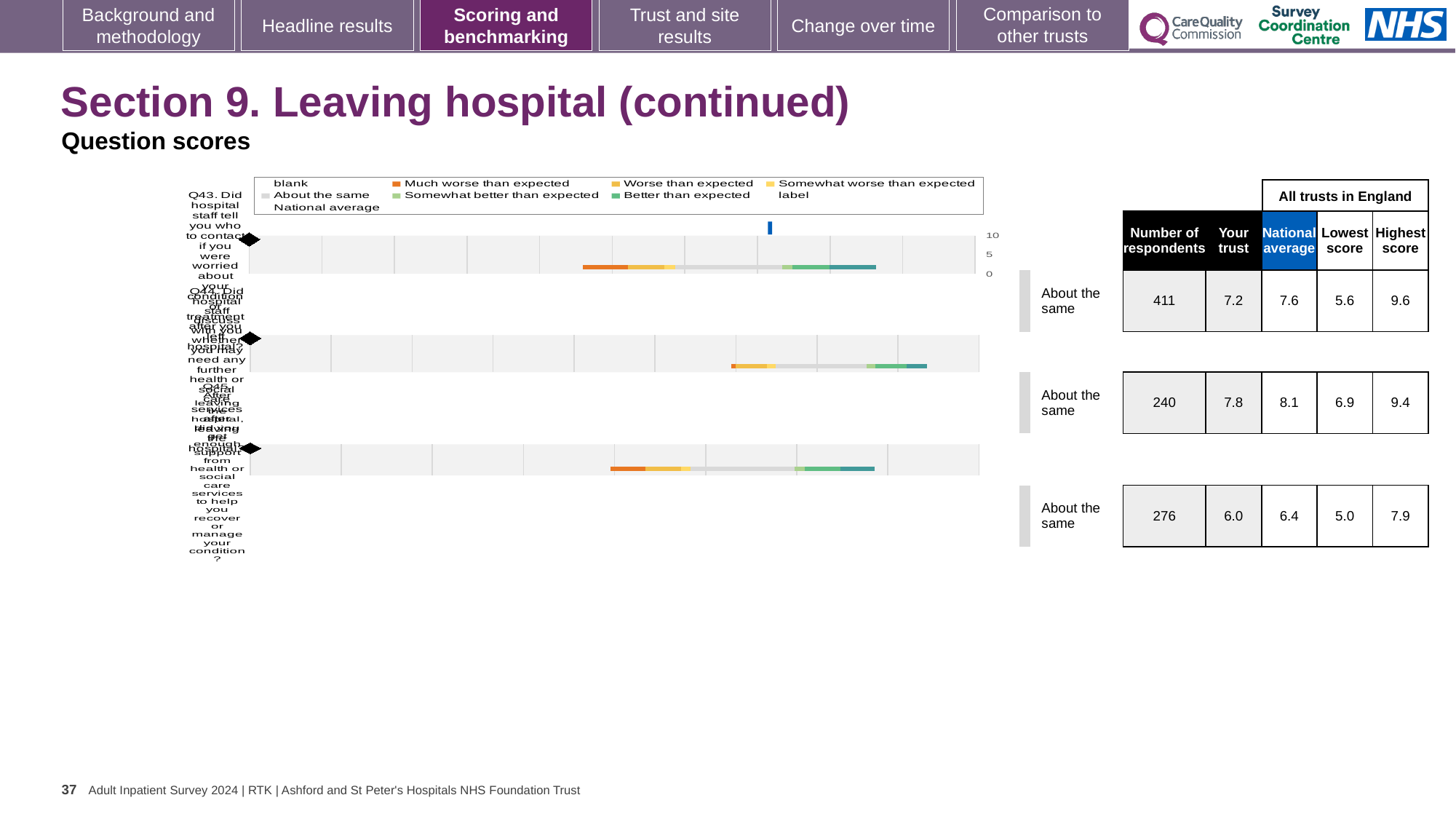
What is the 'Your trust' score for the first question row (Q43)? 7.2 How many respondents are listed for the third question row (Q45)? 276 Which question row has the highest 'Your trust' score? the second row (Q44), 7.8 Which question row has the lowest 'Your trust' score? the third row (Q45), 6.0 What is the highest score among all trusts in England for the first question row (Q43)? 9.6 What kind of chart is used to show the question scores on this slide? bar chart How many questions (rows) are plotted in the chart? 3 For the second question row (Q44), which is larger: the 'Your trust' score or the national average? the national average What benchmark label is shown next to each of the three question rows? About the same What is the national average for the second question row (Q44)? 8.1 For the third question row (Q45), what is the difference between the highest score and the lowest score across all trusts in England? 2.9 For the first question row (Q43), what is the difference between the national average and the 'Your trust' score? 0.4